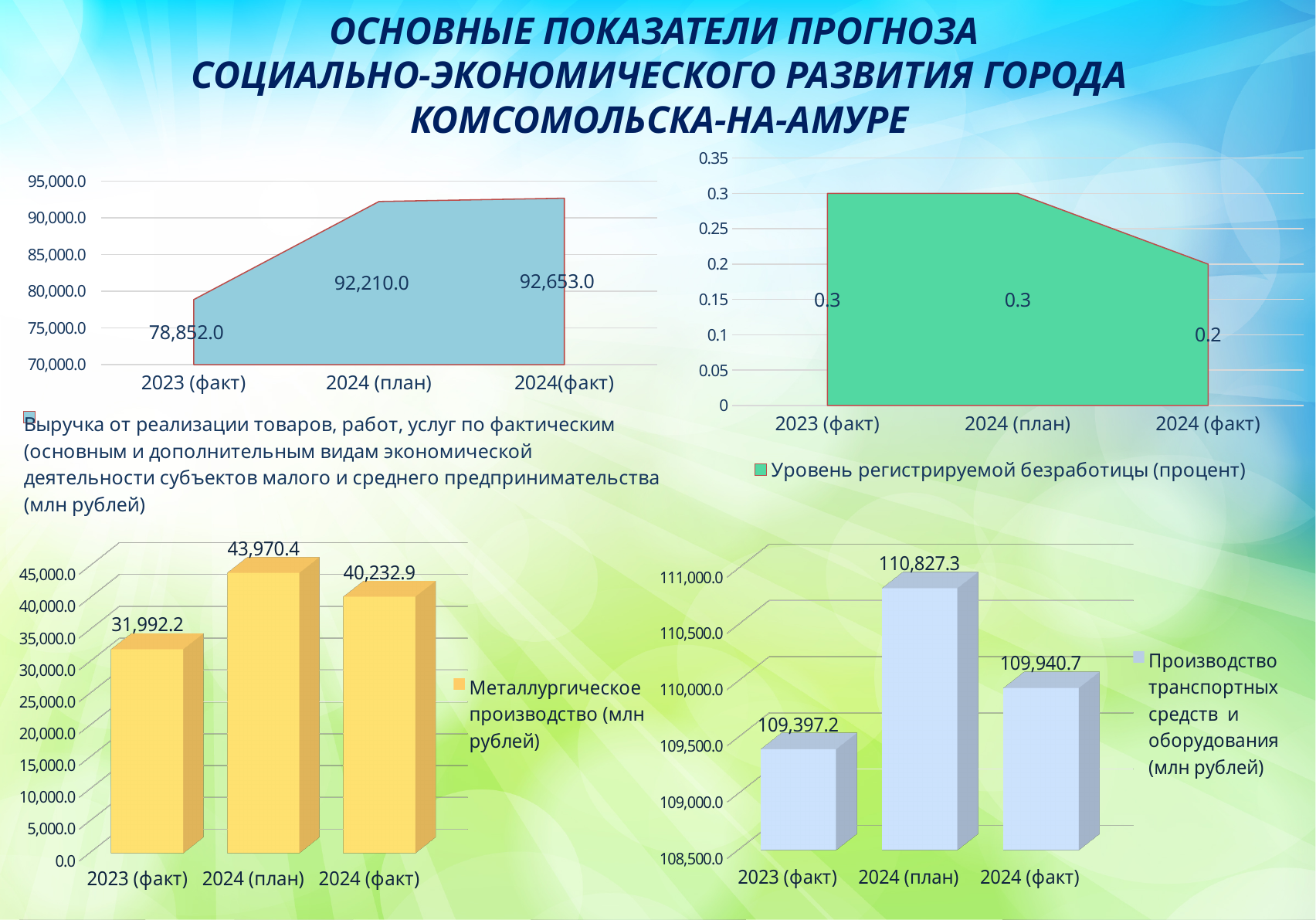
In the bottom-right chart (production of transport vehicles and equipment), which is larger: the value for 2024 (план) or 2024 (факт)? 2024 (план) In the top-left chart (revenue of small and medium enterprises), what is the value for 2024(факт)? 92,653.0 What kind of chart is the bottom-left chart (metallurgical production)? Bar chart How many categories are shown on the x axis of the bottom-right chart (production of transport vehicles and equipment)? 3 In the bottom-left chart (metallurgical production), which category has the highest value? 2024 (план) In the top-right chart (registered unemployment rate), which category has the lowest value? 2024 (факт) In the top-left chart (revenue of small and medium enterprises), what is the difference between the 2024(факт) and 2023 (факт) values? 13,801.0 In the top-right chart (registered unemployment rate), what is the value for 2024 (факт)? 0.2 In the bottom-right chart (production of transport vehicles and equipment), what is the value for 2023 (факт)? 109,397.2 In the bottom-left chart (metallurgical production), what is the difference between the 2024 (план) and 2023 (факт) values? 11,978.2 In the top-left chart (revenue of small and medium enterprises), what is the value for 2023 (факт)? 78,852.0 In the bottom-left chart (metallurgical production), what is the value for 2024 (план)? 43,970.4